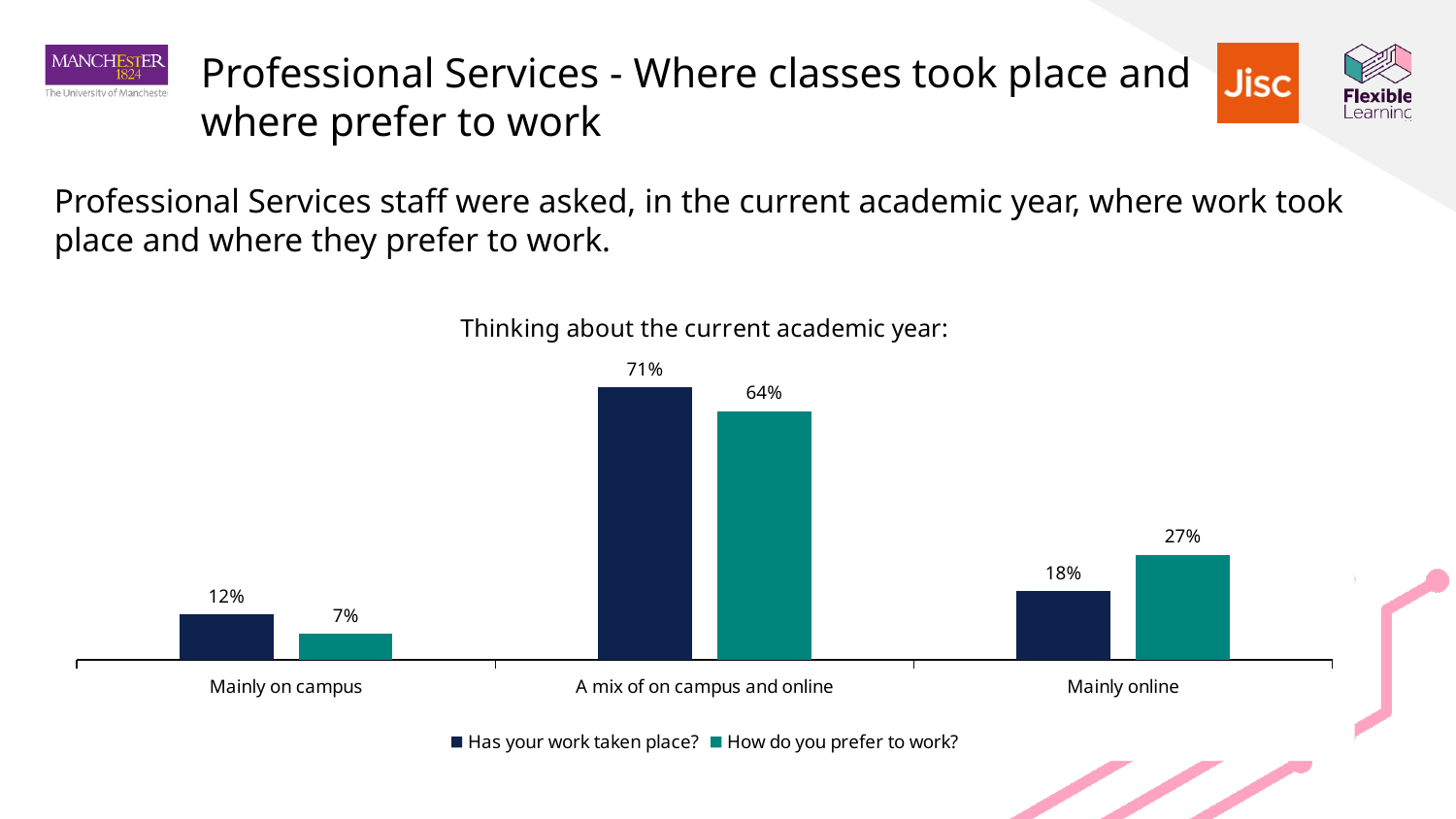
What is the difference between the 'Has your work taken place?' and 'How do you prefer to work?' values for 'A mix of on campus and online'? 7% What percentage of Professional Services staff said their work has mainly taken place on campus? 12% What percentage of staff prefer to work mainly on campus? 7% For 'Mainly online', which is larger: the share whose work has taken place there or the share who prefer to work there? How do you prefer to work? What is the title of the chart? Thinking about the current academic year: What percentage of staff said their work has taken place as a mix of on campus and online? 71% Which category has the highest value for 'Has your work taken place?' A mix of on campus and online What type of chart is shown on the slide? Bar chart How many categories are shown on the x axis of the chart? 3 What percentage of staff prefer to work mainly online? 27% Which category has the lowest value for 'How do you prefer to work?' Mainly on campus How many series does the chart legend list? 2